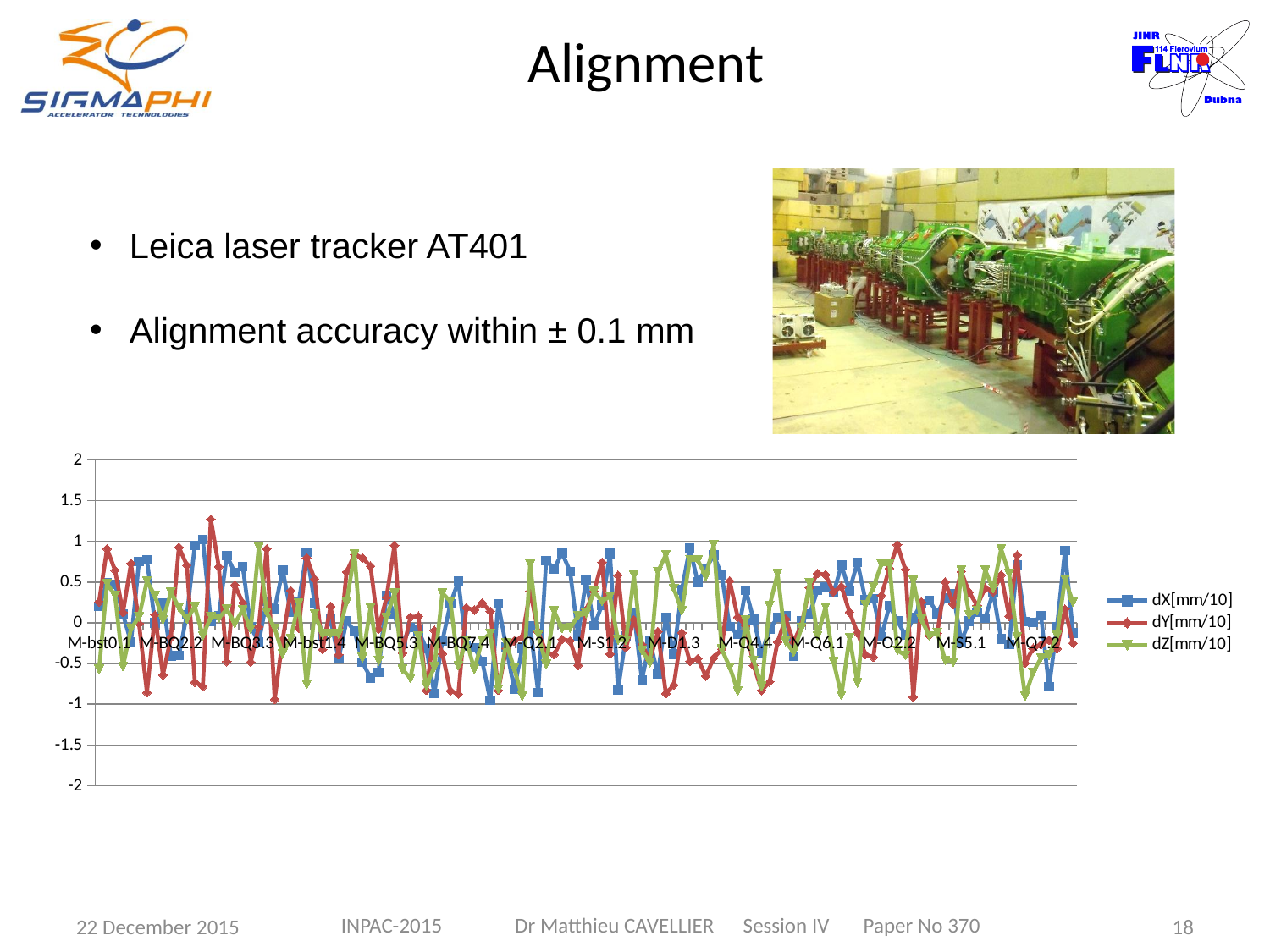
Is the lowest plotted value in the chart greater or less than -1.5? greater What is the first category label on the horizontal axis of the chart? M-bst0.1 Which colour is used for the dY[mm/10] series in the chart? red Is the highest plotted value in the chart greater or less than 1.5? less What kind of chart is shown at the bottom of the slide? line chart How many category labels are printed along the horizontal axis of the chart? 14 What are the names of the three series in the chart legend? dX[mm/10], dY[mm/10], dZ[mm/10] What is the minimum value shown on the vertical axis of the chart? -2 How many series does the legend of the chart list? 3 What is the last category label on the horizontal axis of the chart? M-Q7.2 Which series reaches the highest single value in the chart? dY[mm/10] What is the maximum value shown on the vertical axis of the chart? 2